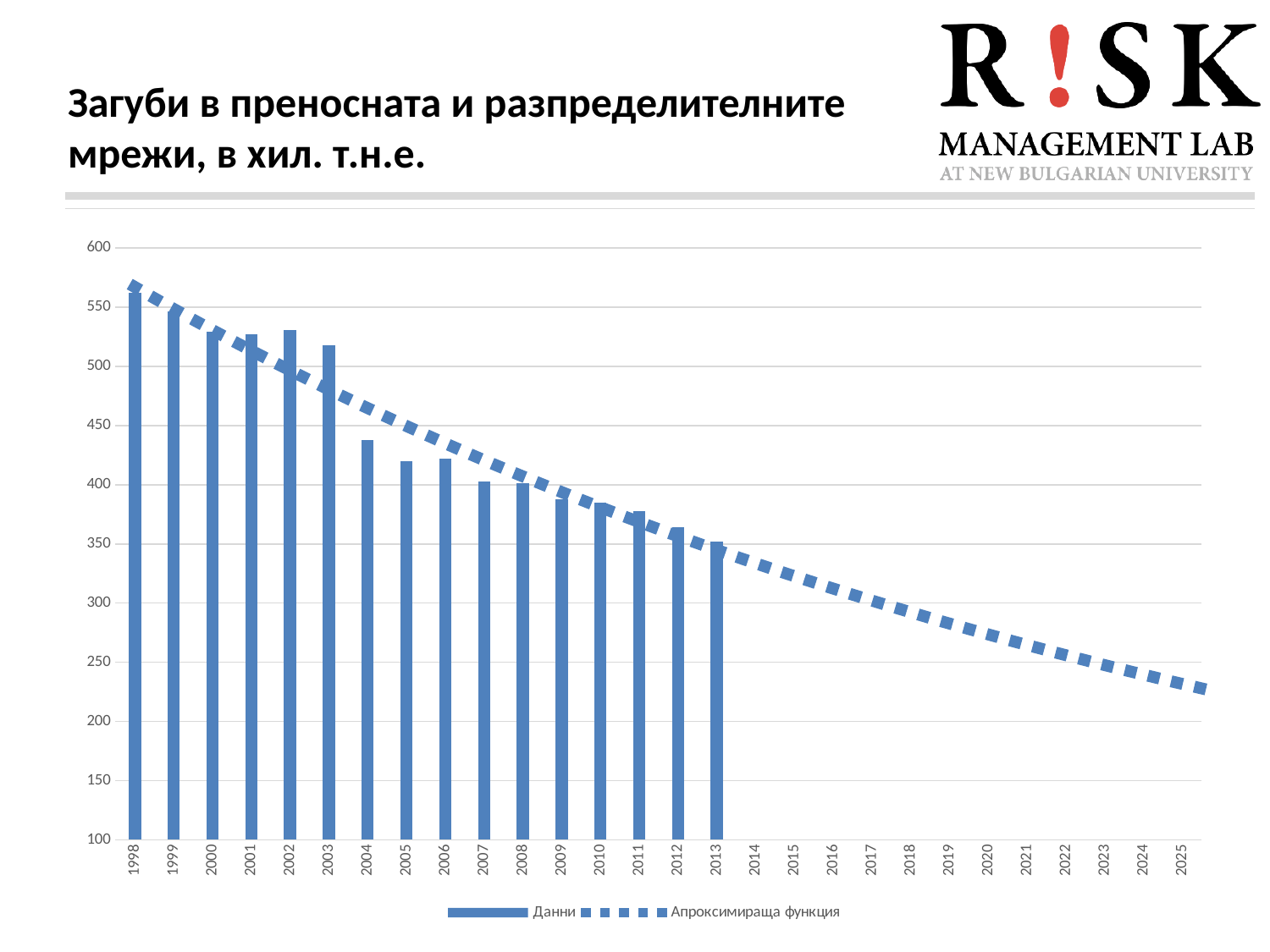
Which year has the larger bar, 2003 or 2004? 2003 Is the value for 2003 greater or less than 500? greater How many series does the legend list? 2 Which year has the highest bar? 1998 Which year has the lowest bar? 2013 What is the name of the dashed-line series in the legend? Апроксимираща функция How many years have a bar plotted in the chart? 16 Is the value for 1998 greater or less than 550? greater Is the value for 2004 greater or less than 450? less What kind of chart is shown on the slide? Bar chart Do the bar values rise or fall from 1998 to 2013? Fall